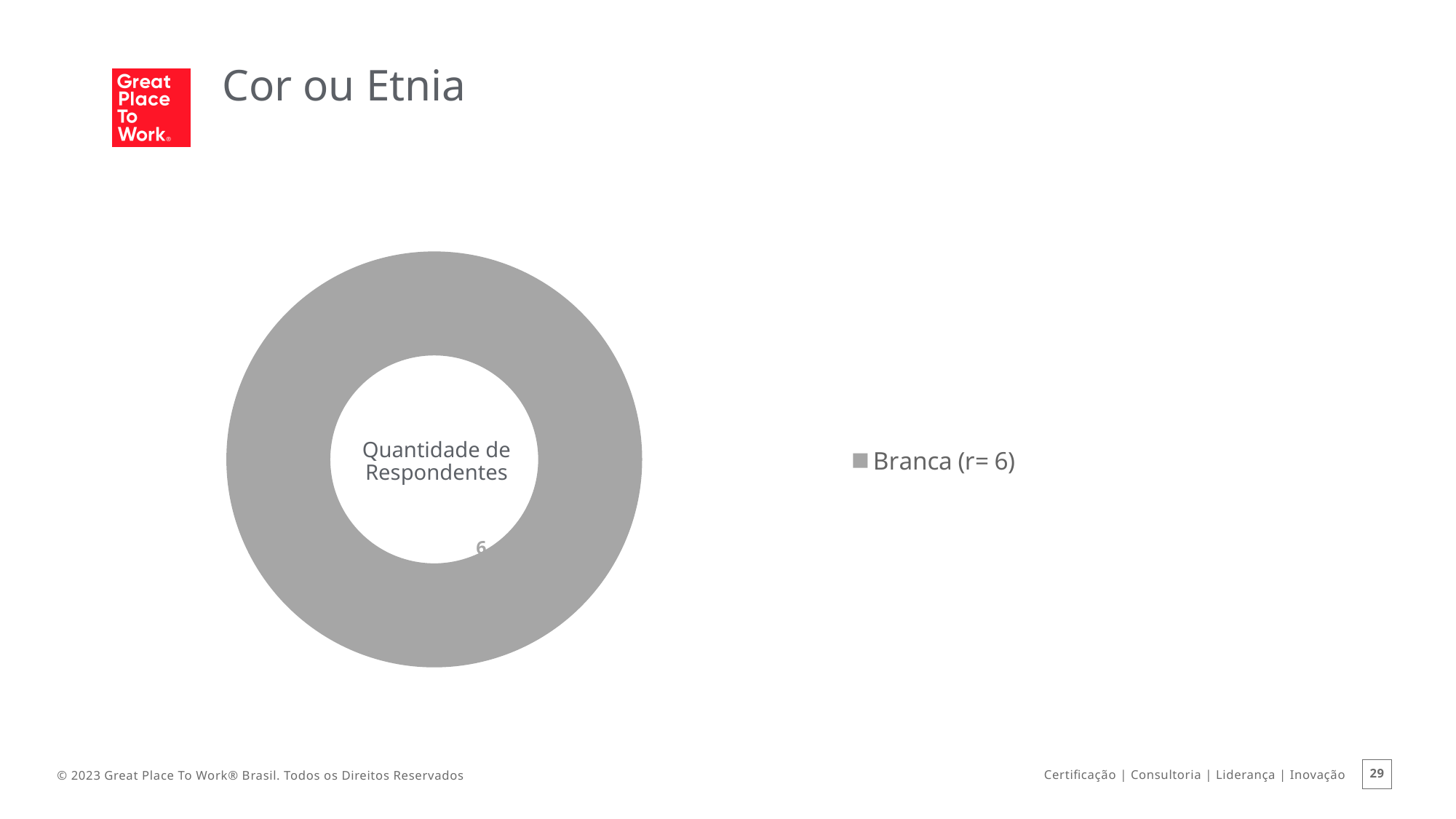
How many entries does the legend list? 1 How many categories does the chart show? 1 Which category has the highest value in the chart? Branca What text appears in the centre of the doughnut chart? Quantidade de Respondentes What share of the doughnut does Branca represent? 100% What kind of chart is shown on the slide? Doughnut (pie) chart What is the legend entry shown next to the chart? Branca (r= 6) What is the value shown for Branca? 6